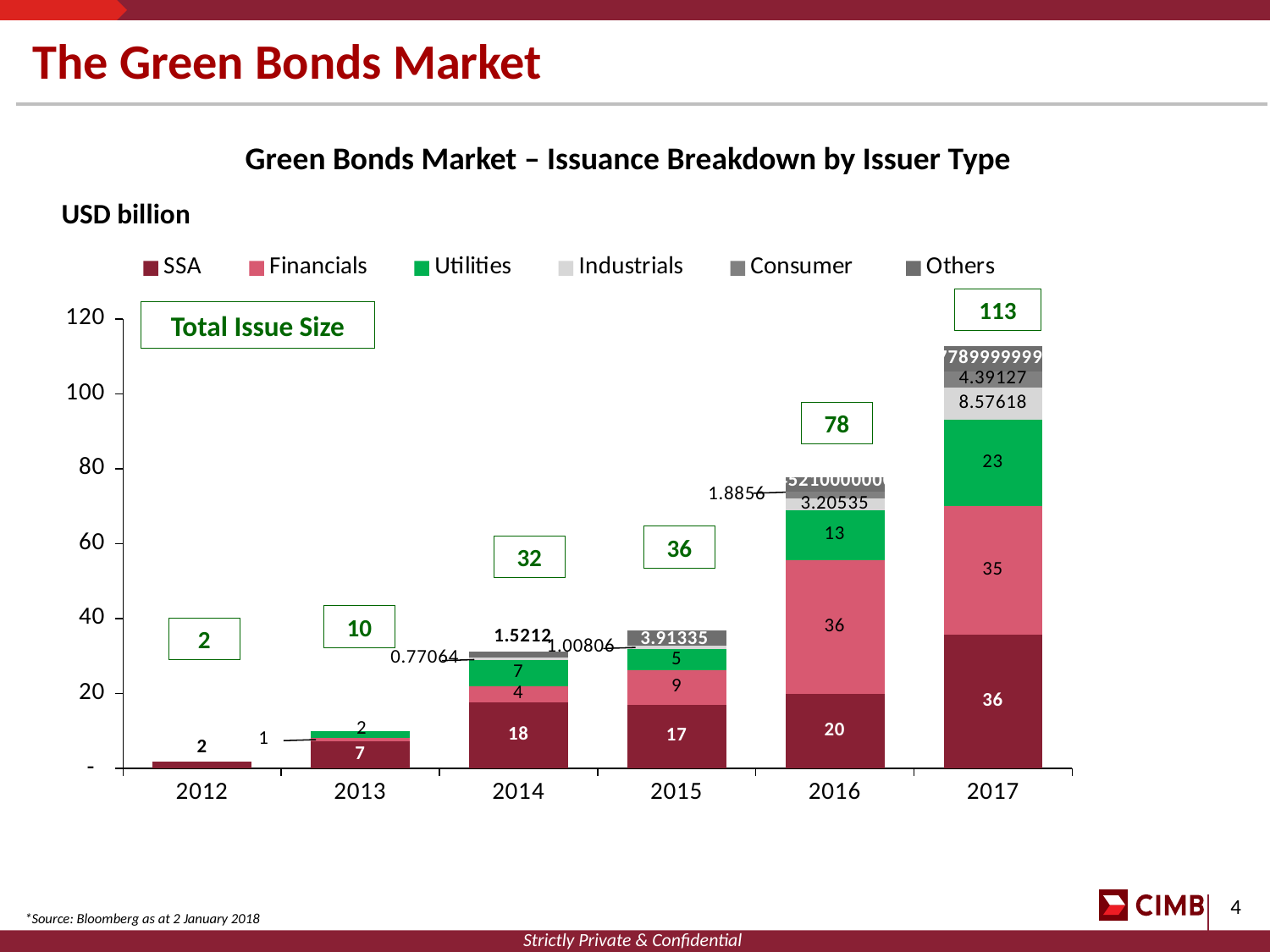
How many years are shown on the x axis? 6 What kind of chart is shown on the slide? Stacked bar chart How many series does the legend list? 6 What is the Financials value for 2016? 36 What is the Utilities value for 2015? 5 Which year has the lowest total issue size? 2012 What is the SSA value for 2017? 36 What is the total issue size for 2016? 78 What is the Industrials value for 2017? 8.57618 Which year has the highest total issue size? 2017 Do the total issue sizes rise or fall from 2012 to 2017? Rise What is the difference between the total issue size in 2017 and in 2016? 35